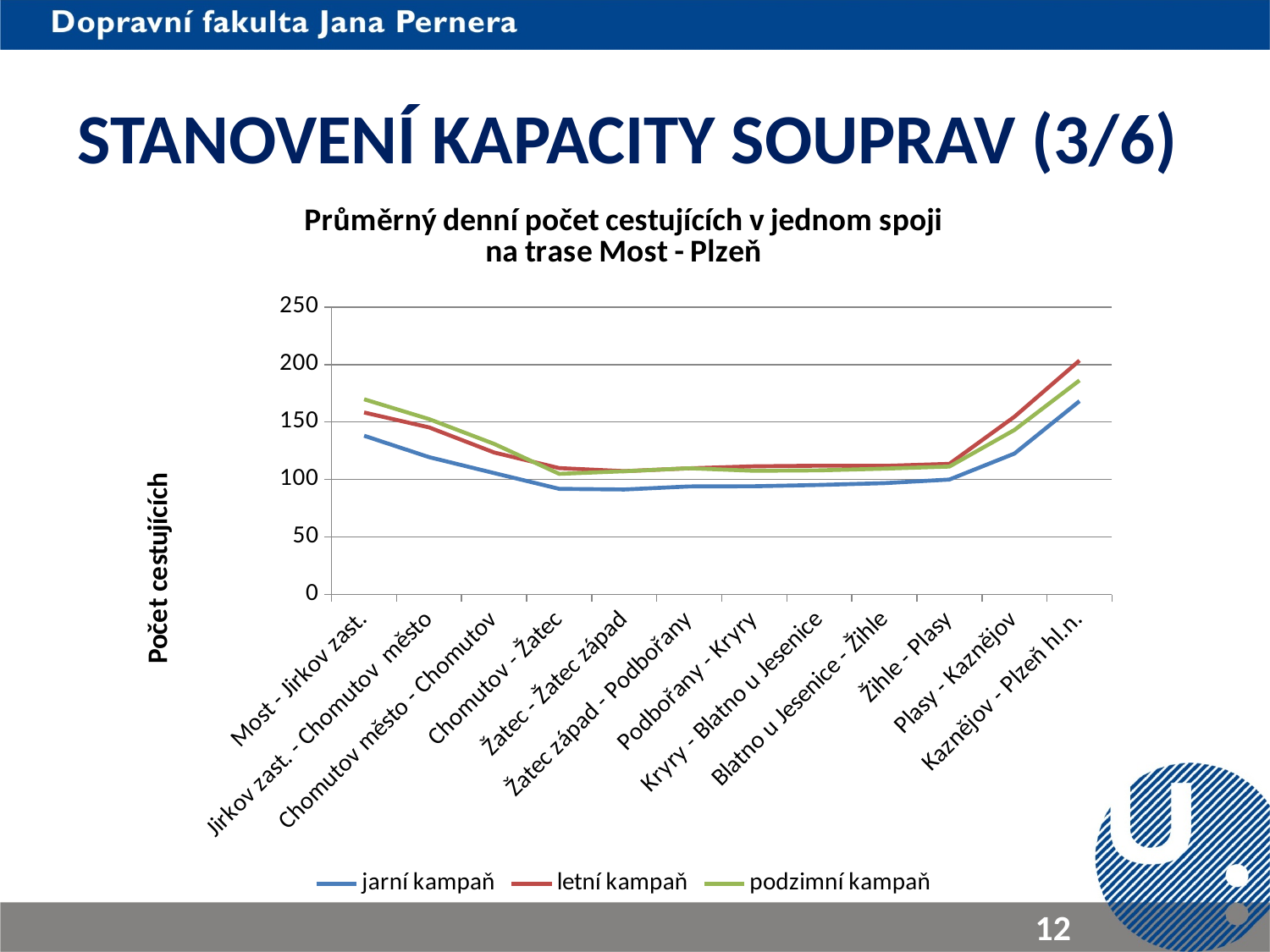
How many series does the legend list? 3 For which route segment does letní kampaň reach its highest value? Kaznějov - Plzeň hl.n. Is the value of podzimní kampaň for Most - Jirkov zast. greater or less than 150? greater What kind of chart is shown on the slide? line chart Is the value of jarní kampaň for Most - Jirkov zast. greater or less than 100? greater How many route segments (categories) are plotted along the x axis? 12 Does the jarní kampaň line rise or fall from Most - Jirkov zast. to Chomutov - Žatec? fall Is the value of letní kampaň for Kaznějov - Plzeň hl.n. greater or less than 150? greater Which series has the highest value at Most - Jirkov zast.? podzimní kampaň At Kaznějov - Plzeň hl.n., which is larger: letní kampaň or jarní kampaň? letní kampaň What is the label of the vertical axis? Počet cestujících